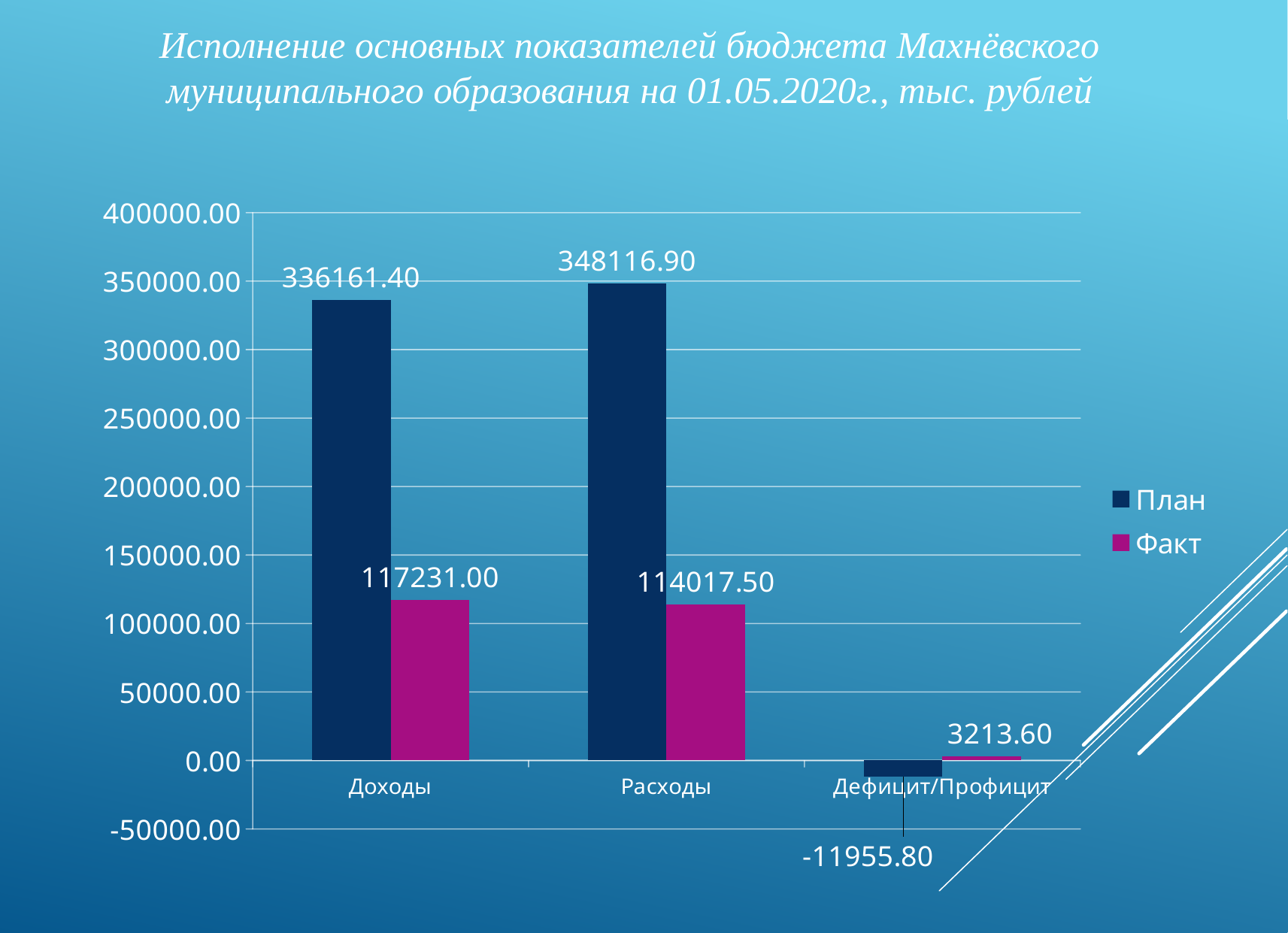
What is the difference between the План and Факт values for Доходы? 218930.40 What is the План value for Доходы? 336161.40 What is the Факт value for Расходы? 114017.50 What is the Факт value for Дефицит/Профицит? 3213.60 Which category has the lowest Факт value? Дефицит/Профицит What is the План value for Дефицит/Профицит? -11955.80 How many categories are shown on the x axis? 3 Which is larger: the Факт value for Доходы or the Факт value for Расходы? Доходы Which category has the highest План value? Расходы What type of chart is shown on the slide? Bar chart What is the difference between the План values for Расходы and Доходы? 11955.50 How many series does the legend list? 2